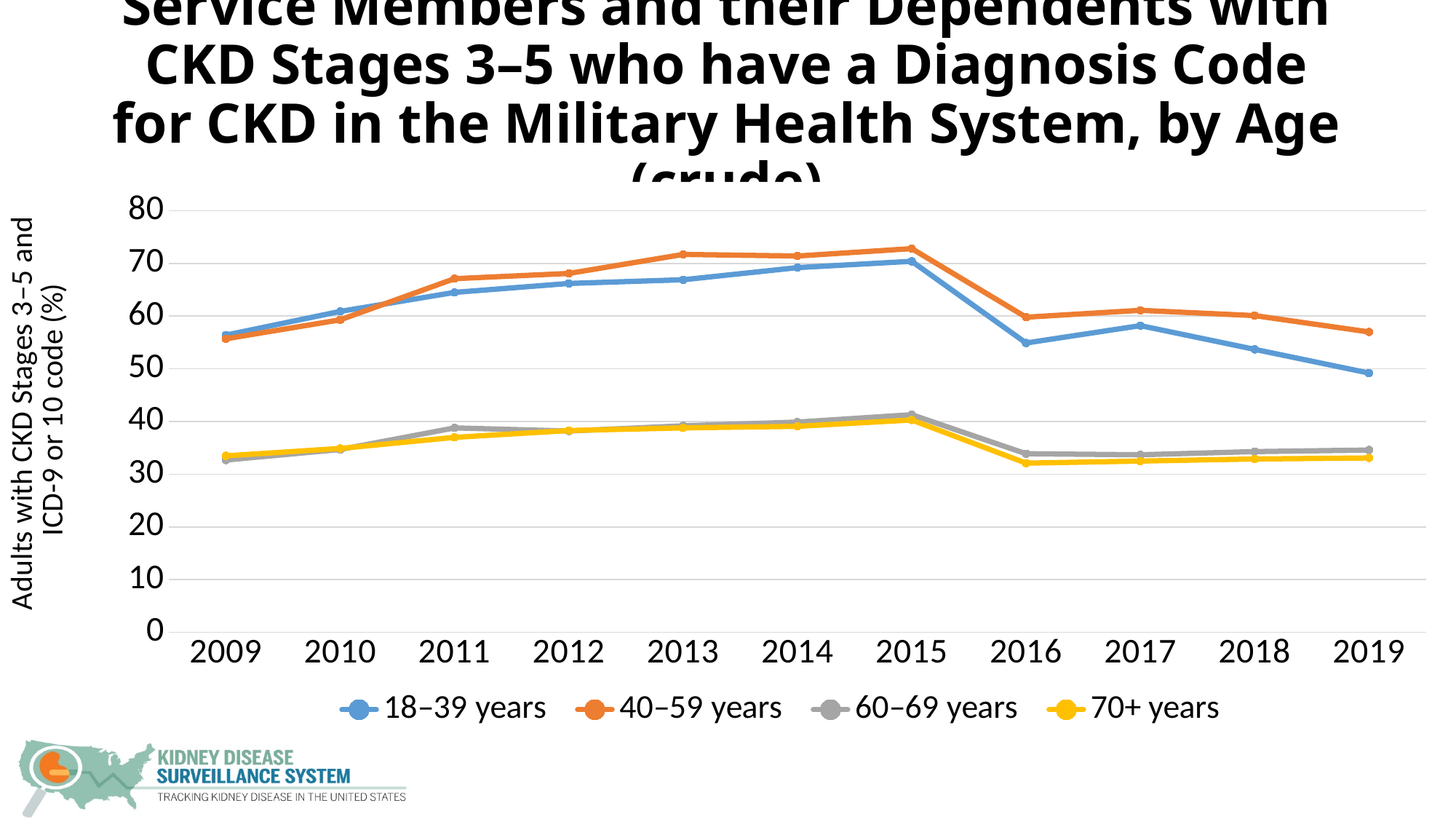
What is the label on the y axis? Adults with CKD Stages 3–5 and ICD-9 or 10 code (%) Is the value for 40–59 years in 2015 greater or less than 70? greater What kind of chart is shown on the slide? line chart Which age group has the highest value in 2019? 40–59 years Is the value for 70+ years in 2016 greater or less than 40? less How many years are shown along the x axis? 11 How many series does the legend list? 4 In which year is the value for 18–39 years lowest? 2019 Does the value for 40–59 years rise or fall from 2009 to 2015? rise Is the value for 18–39 years in 2016 greater or less than 60? less Does the value for 18–39 years rise or fall from 2015 to 2019? fall In 2015, which is larger: the value for 18–39 years or the value for 60–69 years? 18–39 years